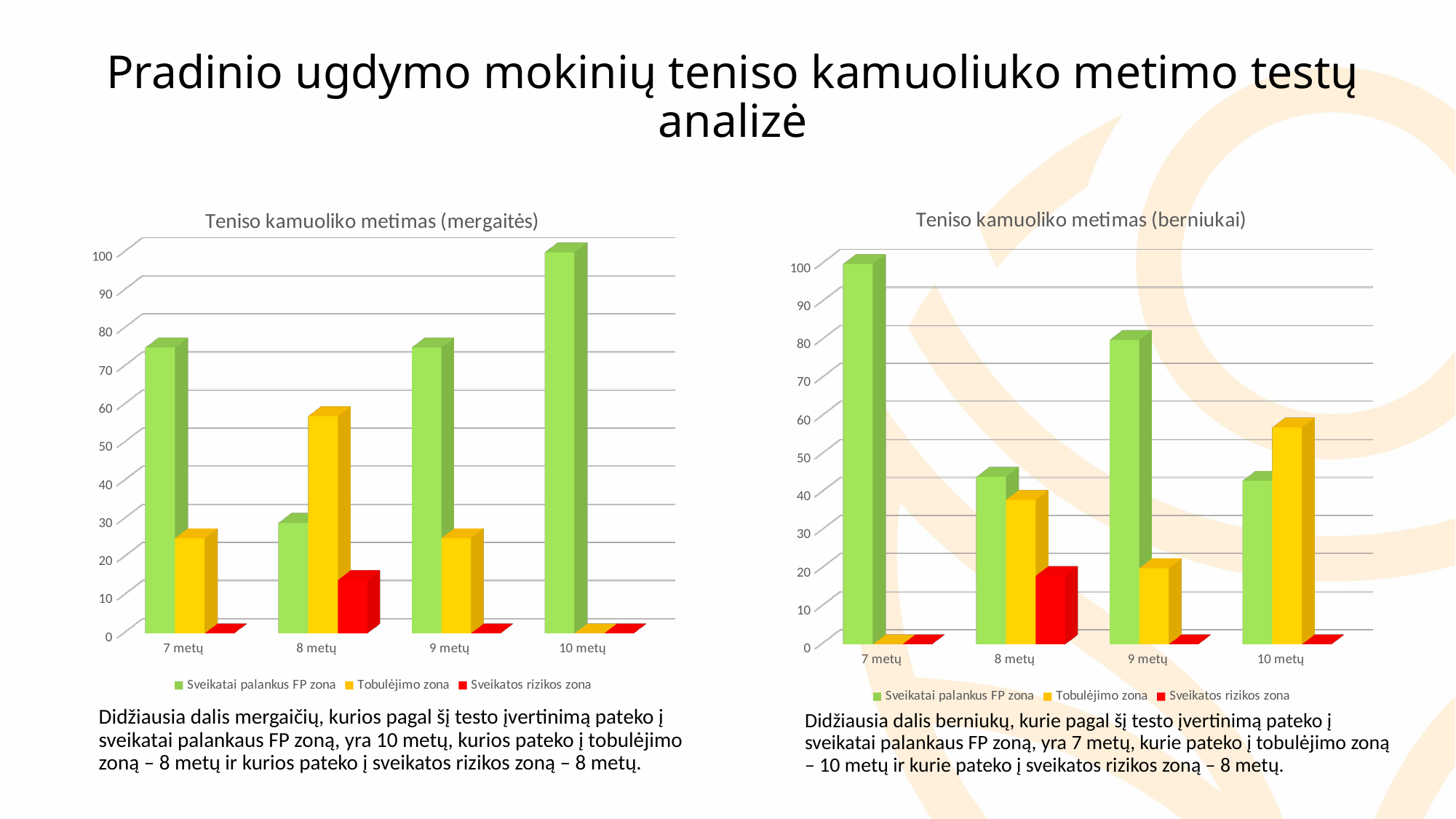
In "Teniso kamuoliko metimas (mergaitės)", which age group has the highest value for Sveikatai palankus FP zona? 10 metų In "Teniso kamuoliko metimas (berniukai)", which is larger at 10 metų: Sveikatai palankus FP zona or Tobulėjimo zona? Tobulėjimo zona How many age categories are shown on the x axis of "Teniso kamuoliko metimas (mergaitės)"? 4 In "Teniso kamuoliko metimas (berniukai)", is the value for Sveikatai palankus FP zona at 9 metų greater or less than 70? greater How many series does the legend of "Teniso kamuoliko metimas (berniukai)" list? 3 In "Teniso kamuoliko metimas (mergaitės)", which age group has the lowest value for Sveikatai palankus FP zona? 8 metų What colour represents Sveikatos rizikos zona in the charts? red In "Teniso kamuoliko metimas (berniukai)", which age group has the highest value for Sveikatai palankus FP zona? 7 metų What kind of chart is "Teniso kamuoliko metimas (mergaitės)"? bar chart In "Teniso kamuoliko metimas (mergaitės)", is the value for Tobulėjimo zona at 8 metų greater or less than 50? greater In "Teniso kamuoliko metimas (berniukai)", is the value for Sveikatos rizikos zona at 8 metų greater or less than 30? less In "Teniso kamuoliko metimas (mergaitės)", which is larger at 7 metų: Sveikatai palankus FP zona or Tobulėjimo zona? Sveikatai palankus FP zona